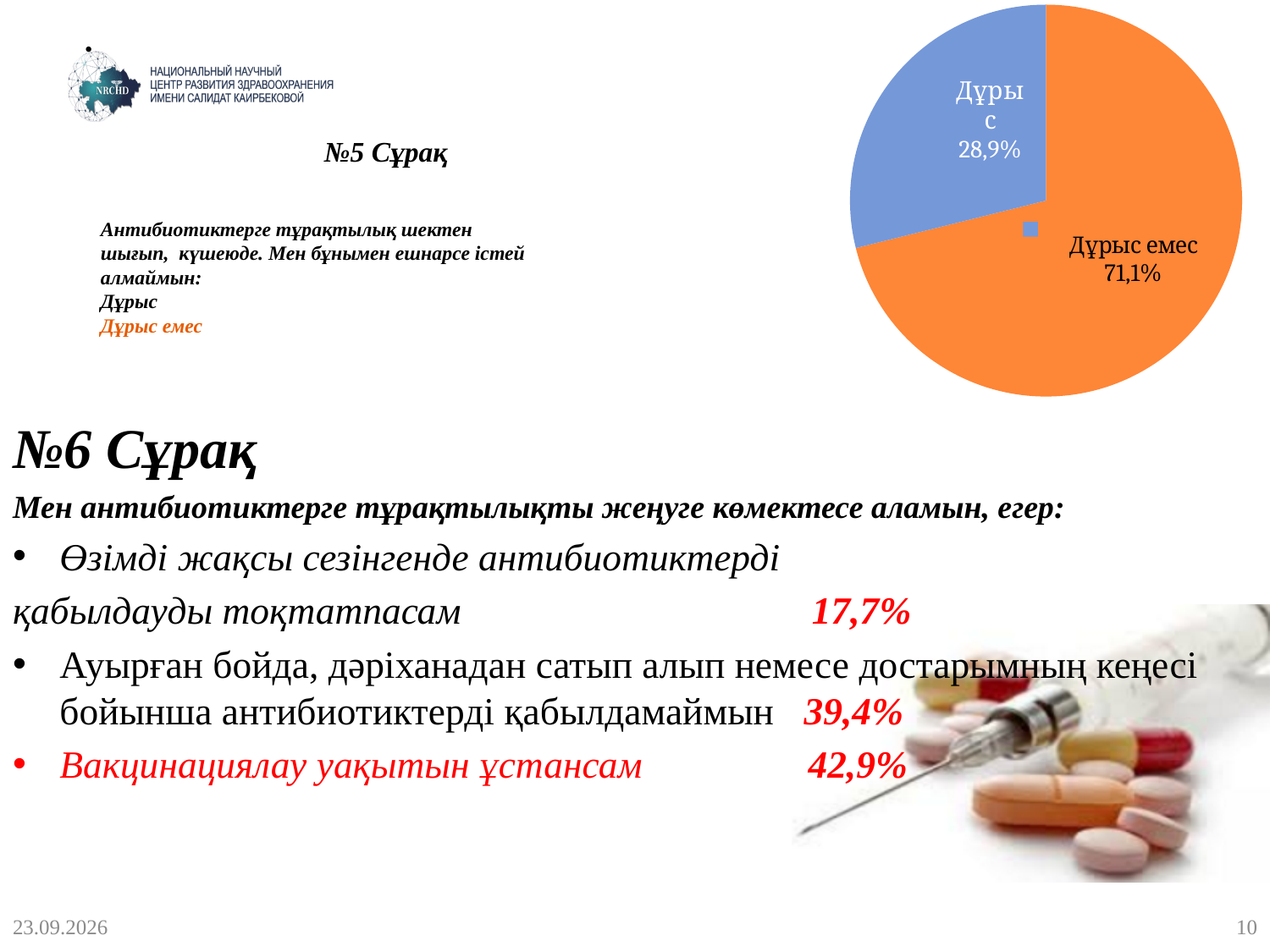
Which is larger in the pie chart, "Дұрыс" or "Дұрыс емес"? Дұрыс емес What percentage does the pie chart show for "Дұрыс емес"? 71,1% What percentage does the pie chart show for "Дұрыс"? 28,9% What is the difference in percentage points between "Дұрыс емес" and "Дұрыс" in the pie chart? 42,2 Which slice of the pie chart is the largest? Дұрыс емес Which slice of the pie chart is the smallest? Дұрыс How many slices does the pie chart have? 2 What colour is the "Дұрыс емес" slice in the pie chart? orange What colour is the "Дұрыс" slice in the pie chart? blue What kind of chart is shown on the slide? pie chart What share of the pie does the "Дұрыс емес" slice represent? 71,1%